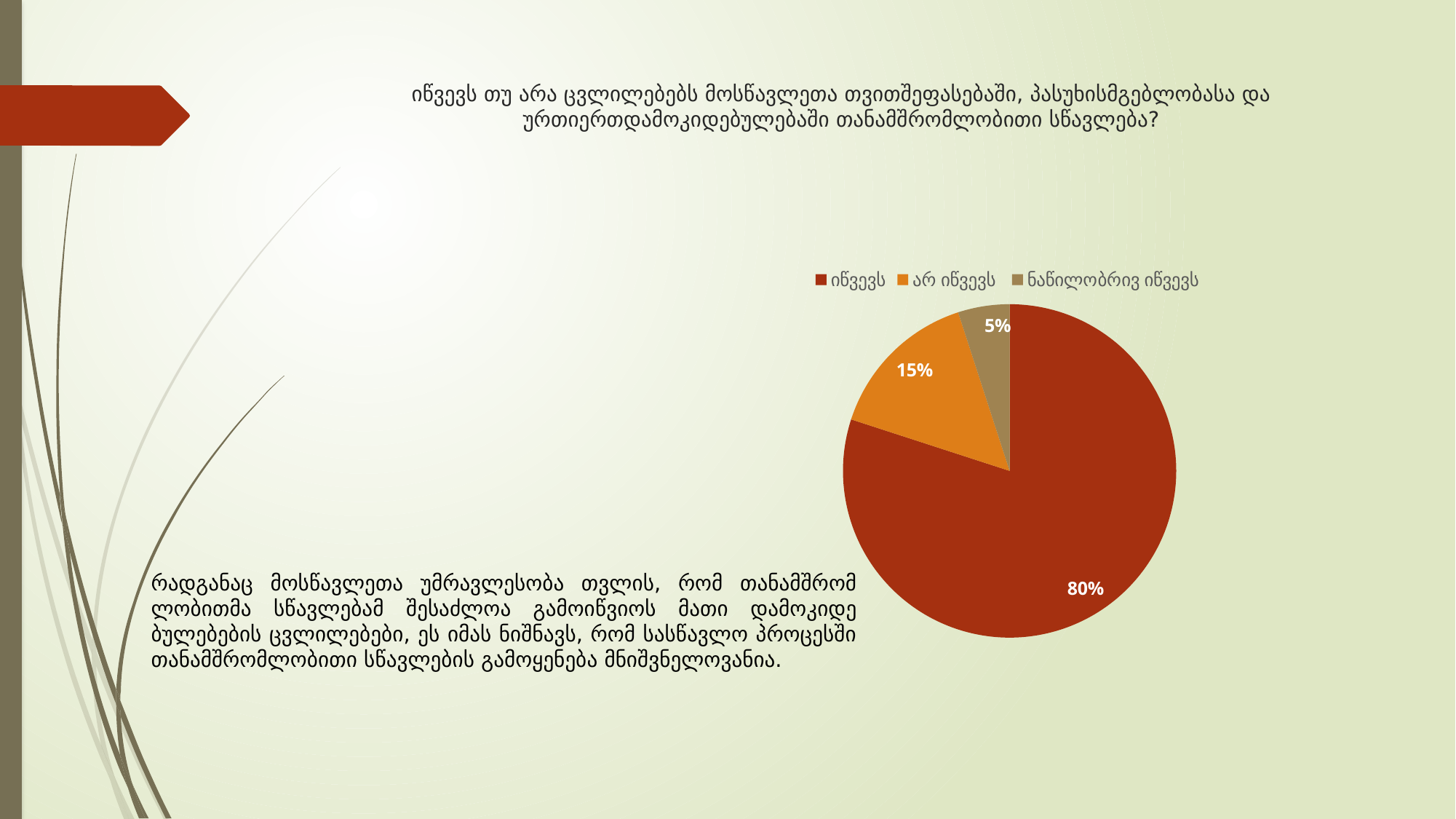
Which is larger, the slice for "არ იწვევს" or the slice for "ნაწილობრივ იწვევს"? არ იწვევს What is the difference in percentage points between "იწვევს" and "არ იწვევს"? 65 How many entries does the legend list? 3 Which category has the largest slice of the pie? იწვევს Which category has the smallest slice of the pie? ნაწილობრივ იწვევს What is the difference in percentage points between "არ იწვევს" and "ნაწილობრივ იწვევს"? 10 What colour is the slice for "არ იწვევს"? orange What share of the pie does "იწვევს" have? 80% What share of the pie does "არ იწვევს" have? 15% What share of the pie does "ნაწილობრივ იწვევს" have? 5% How many slices does the pie chart have? 3 What kind of chart is shown on the slide? pie chart